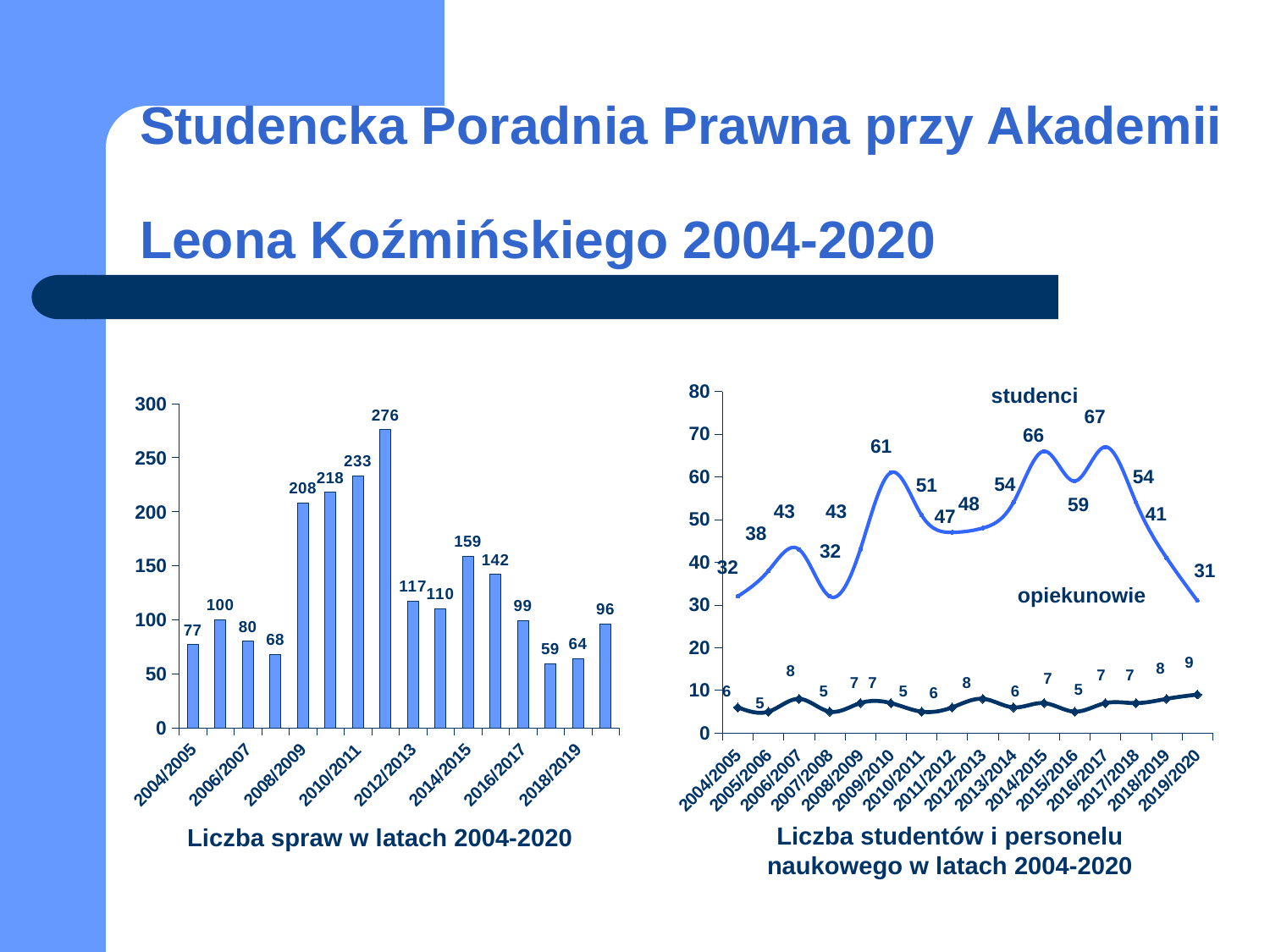
In the chart 'Liczba studentów i personelu naukowego w latach 2004-2020', what is the value for studenci in 2009/2010? 61 In the chart 'Liczba spraw w latach 2004-2020', what is the highest value shown? 276 In the chart 'Liczba studentów i personelu naukowego w latach 2004-2020', what is the value for opiekunowie in 2019/2020? 9 What kind of chart is 'Liczba spraw w latach 2004-2020'? bar chart In the chart 'Liczba spraw w latach 2004-2020', what is the lowest value shown? 59 In the chart 'Liczba studentów i personelu naukowego w latach 2004-2020', in which year does studenci reach its highest value? 2016/2017 How many academic years are plotted on the x axis of the chart 'Liczba studentów i personelu naukowego w latach 2004-2020'? 16 In the chart 'Liczba spraw w latach 2004-2020', what is the value for 2004/2005? 77 In the chart 'Liczba spraw w latach 2004-2020', what is the difference between the values for 2006/2007 and 2004/2005? 3 In the chart 'Liczba spraw w latach 2004-2020', what is the value for 2010/2011? 233 In the chart 'Liczba spraw w latach 2004-2020', what is the value for 2018/2019? 64 In the chart 'Liczba spraw w latach 2004-2020', which is larger: the value for 2008/2009 or the value for 2012/2013? 2008/2009